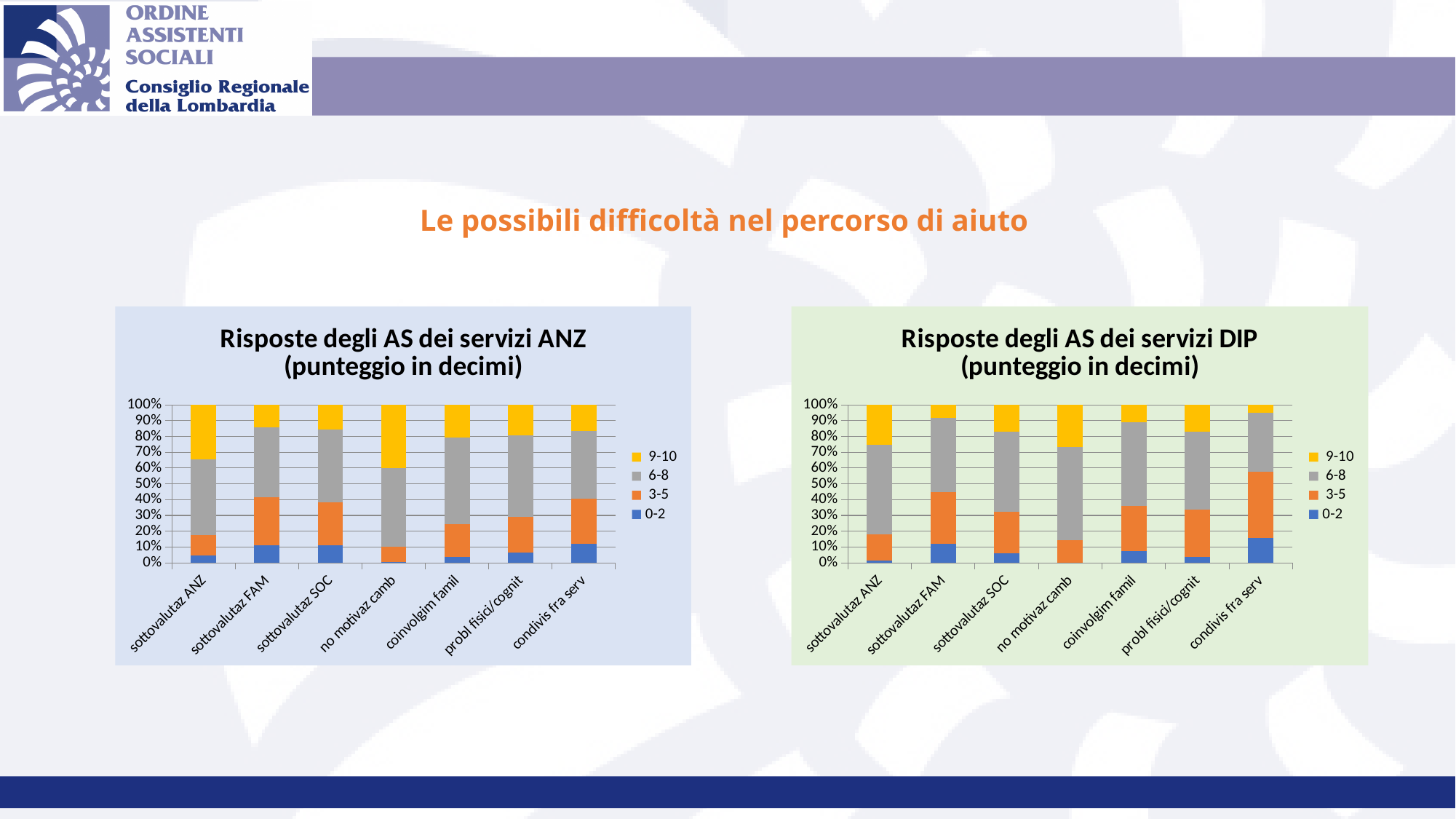
How many categories are shown on the x axis of the 'Risposte degli AS dei servizi DIP (punteggio in decimi)' chart? 7 In the 'Risposte degli AS dei servizi DIP' chart, is the 3-5 segment larger for 'condivis fra serv' or for 'no motivaz camb'? condivis fra serv In the 'Risposte degli AS dei servizi ANZ' chart, is the 9-10 segment for 'no motivaz camb' greater or less than 30% of the bar? greater How many series does the legend of the 'Risposte degli AS dei servizi ANZ (punteggio in decimi)' chart list? 4 What kind of chart is the 'Risposte degli AS dei servizi ANZ (punteggio in decimi)' chart? Stacked bar chart In the 'Risposte degli AS dei servizi ANZ' chart, which category has the largest 9-10 segment? no motivaz camb In the 'Risposte degli AS dei servizi DIP' chart, is the 9-10 segment for 'condivis fra serv' greater or less than 10% of the bar? less What are the legend entries of the 'Risposte degli AS dei servizi DIP (punteggio in decimi)' chart? 9-10, 6-8, 3-5, 0-2 In the 'Risposte degli AS dei servizi DIP' chart, is the 3-5 segment for 'condivis fra serv' greater or less than 30% of the bar? greater In the 'Risposte degli AS dei servizi ANZ' chart, is the 9-10 segment larger for 'no motivaz camb' or for 'coinvolgim famil'? no motivaz camb What is the title of the chart on the right side of the slide? Risposte degli AS dei servizi DIP (punteggio in decimi)